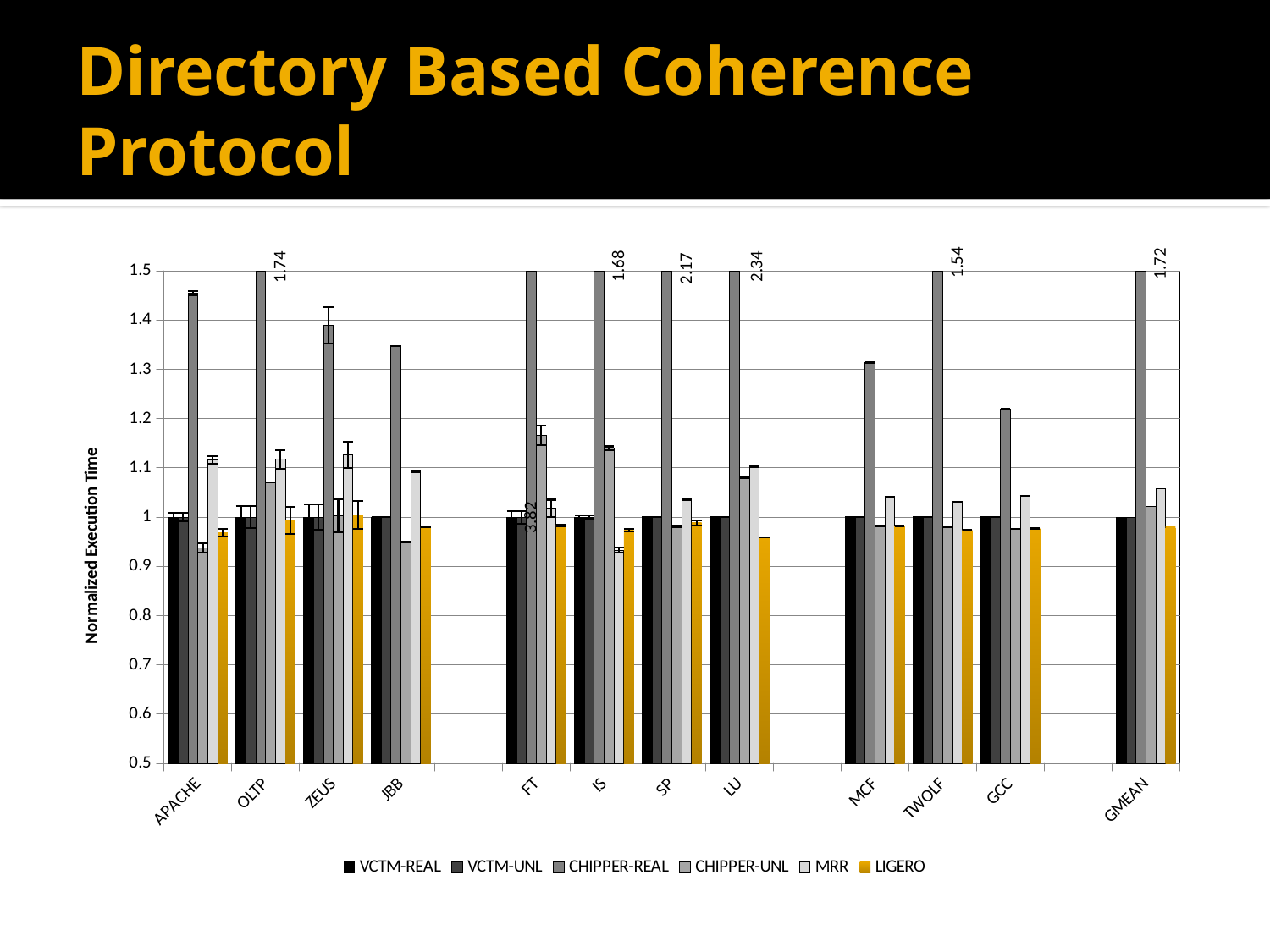
How many series does the legend list? 6 What is the difference between the CHIPPER-REAL values for LU and SP? 0.17 What is the labelled CHIPPER-REAL value for GMEAN? 1.72 What is the labelled CHIPPER-REAL value for LU? 2.34 Is the CHIPPER-REAL value for JBB greater or less than 1.3? greater What kind of chart is shown on the slide? bar chart How many categories are shown along the x axis? 12 Which is larger, the CHIPPER-REAL value for SP or for LU? LU What is the labelled CHIPPER-REAL value for TWOLF? 1.54 What is the labelled CHIPPER-REAL value for FT? 3.82 What is the title of the y axis? Normalized Execution Time Which category has the highest CHIPPER-REAL value? FT